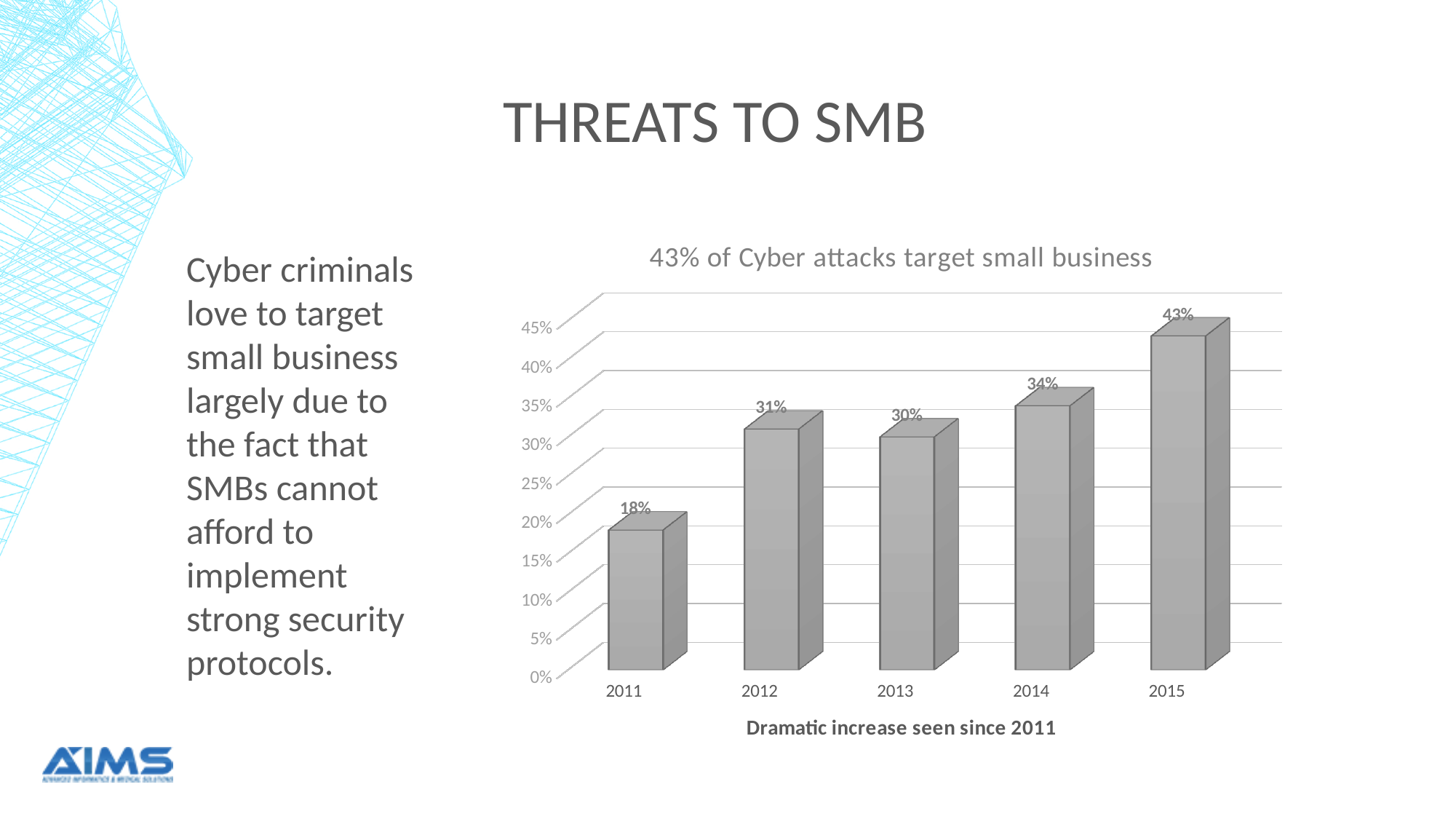
Is the value for 2014 greater or less than 30%? greater What is the title of the chart? 43% of Cyber attacks target small business What is the difference between the values for 2015 and 2011? 25% Which year has the lowest value? 2011 What kind of chart is shown on the slide? Bar chart What is the value for 2011? 18% What is the value for 2015? 43% How many years are shown on the x axis? 5 Which year has the highest value? 2015 Which is larger, the value for 2012 or the value for 2014? 2014 What is the value for 2013? 30% What is the difference between the values for 2014 and 2013? 4%